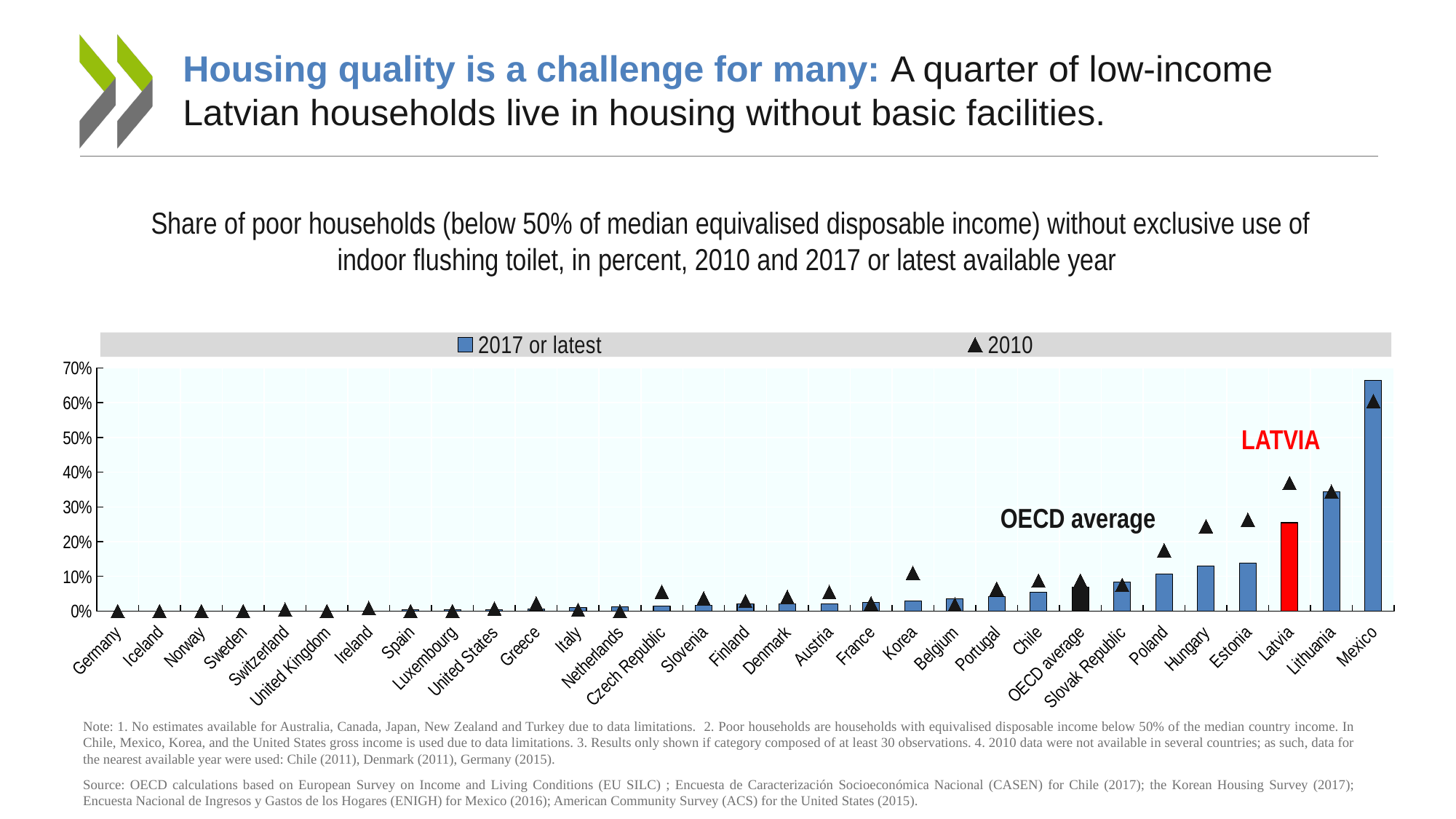
Is the 2017 or latest value for Estonia greater or less than 20%? less Which has the larger 2017 or latest value, Latvia or Lithuania? Lithuania How many categories are shown on the x axis? 31 Is the 2017 or latest value for Mexico greater or less than 60%? greater Which country has the highest 2017 or latest value? Mexico Which country's bar is highlighted in red? Latvia Is the 2017 or latest value for Latvia greater or less than 20%? greater Which has the larger 2017 or latest value, Poland or Estonia? Estonia What kind of chart is shown on the slide? bar chart Do the 2017 or latest values generally rise or fall moving from left to right along the x axis? rise How many series does the legend list? 2